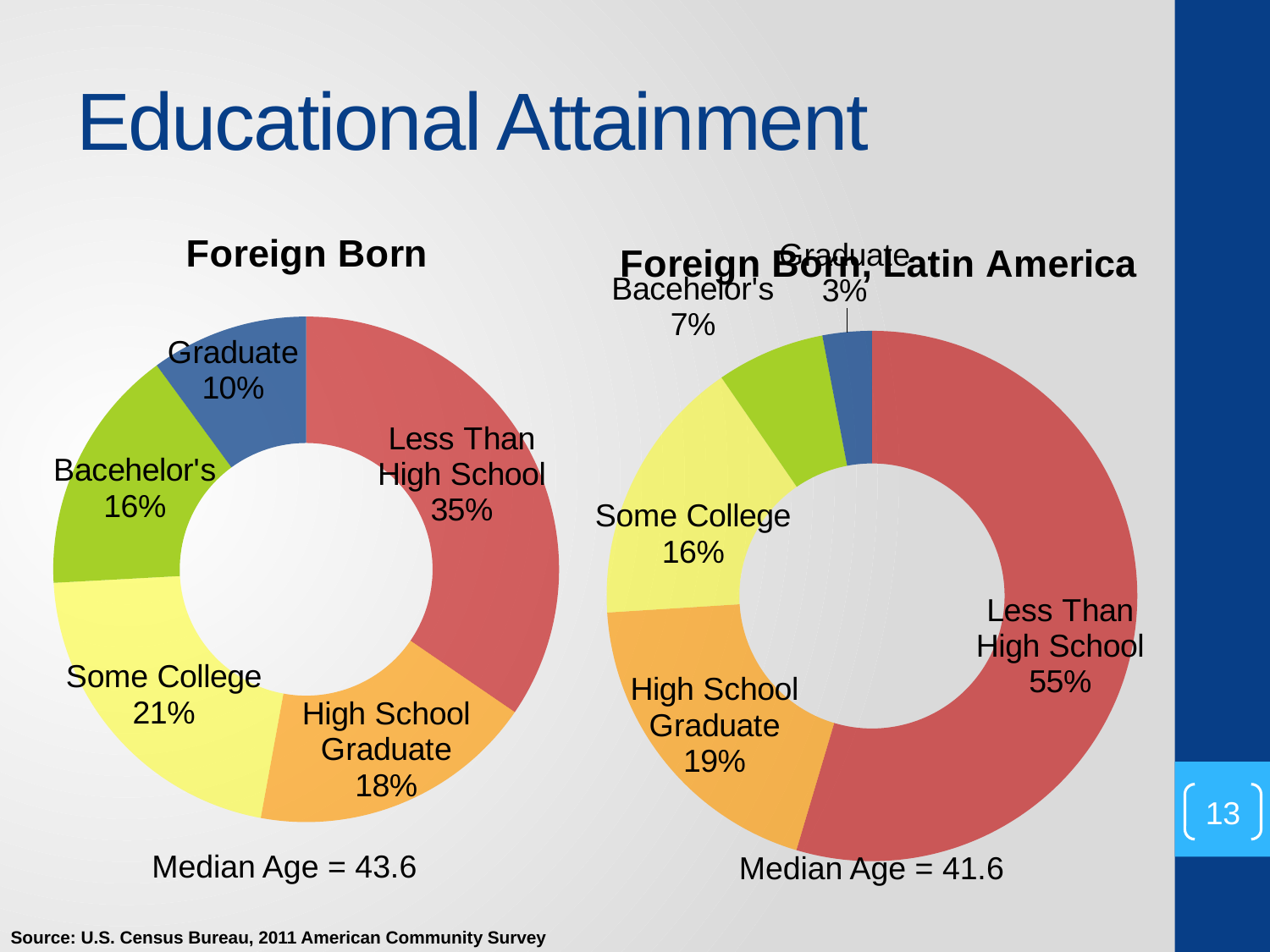
What kind of chart is the "Foreign Born, Latin America" chart? Pie chart (doughnut) In the "Foreign Born, Latin America" chart, what share is High School Graduate? 19% In the "Foreign Born, Latin America" chart, what share is Less Than High School? 55% Which chart shows a larger share for Bachelor's, "Foreign Born" or "Foreign Born, Latin America"? Foreign Born How many categories does the "Foreign Born" chart show? 5 In the "Foreign Born, Latin America" chart, which category has the smallest share? Graduate In the "Foreign Born" chart, what share is Some College? 21% In the "Foreign Born" chart, what is the difference between the Less Than High School share and the Graduate share? 25% In the "Foreign Born, Latin America" chart, what is the difference between the Some College share and the Bachelor's share? 9% In the "Foreign Born" chart, which category has the largest share? Less Than High School What median age is shown below the "Foreign Born, Latin America" chart? 41.6 In the "Foreign Born" chart, what share is Less Than High School? 35%